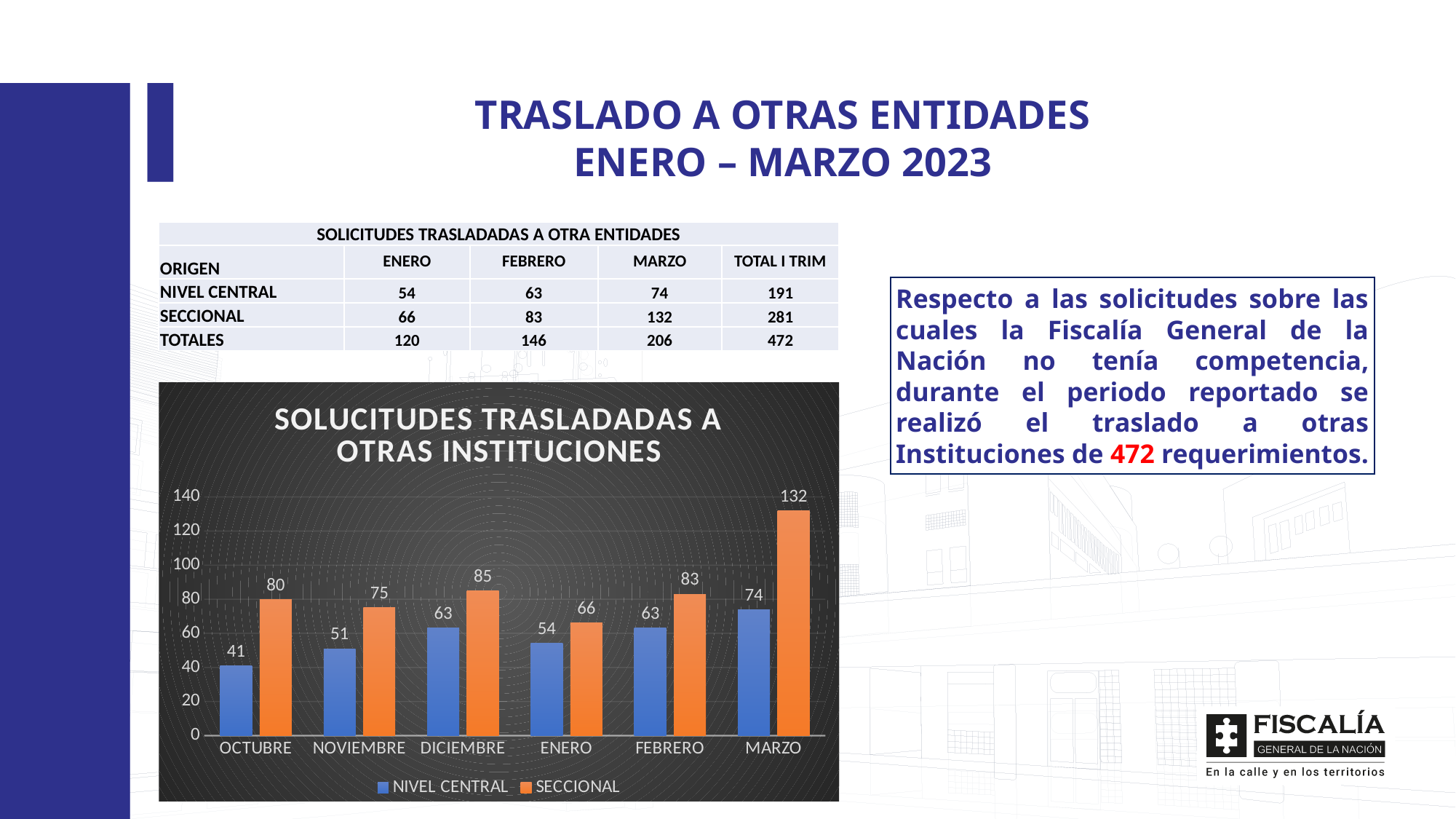
What is the value for NIVEL CENTRAL in OCTUBRE? 41 What kind of chart is shown on the slide? Bar chart What is the value for SECCIONAL in MARZO? 132 What is the value for SECCIONAL in DICIEMBRE? 85 How many months are shown on the x axis of the chart? 6 What is the difference between SECCIONAL and NIVEL CENTRAL in MARZO? 58 Which month has the highest SECCIONAL value? MARZO What is the title of the chart? SOLUCITUDES TRASLADADAS A OTRAS INSTITUCIONES How many series does the chart legend list? 2 Which month has the lowest NIVEL CENTRAL value? OCTUBRE Which is larger in ENERO, NIVEL CENTRAL or SECCIONAL? SECCIONAL Do the NIVEL CENTRAL values rise or fall from OCTUBRE to DICIEMBRE? Rise